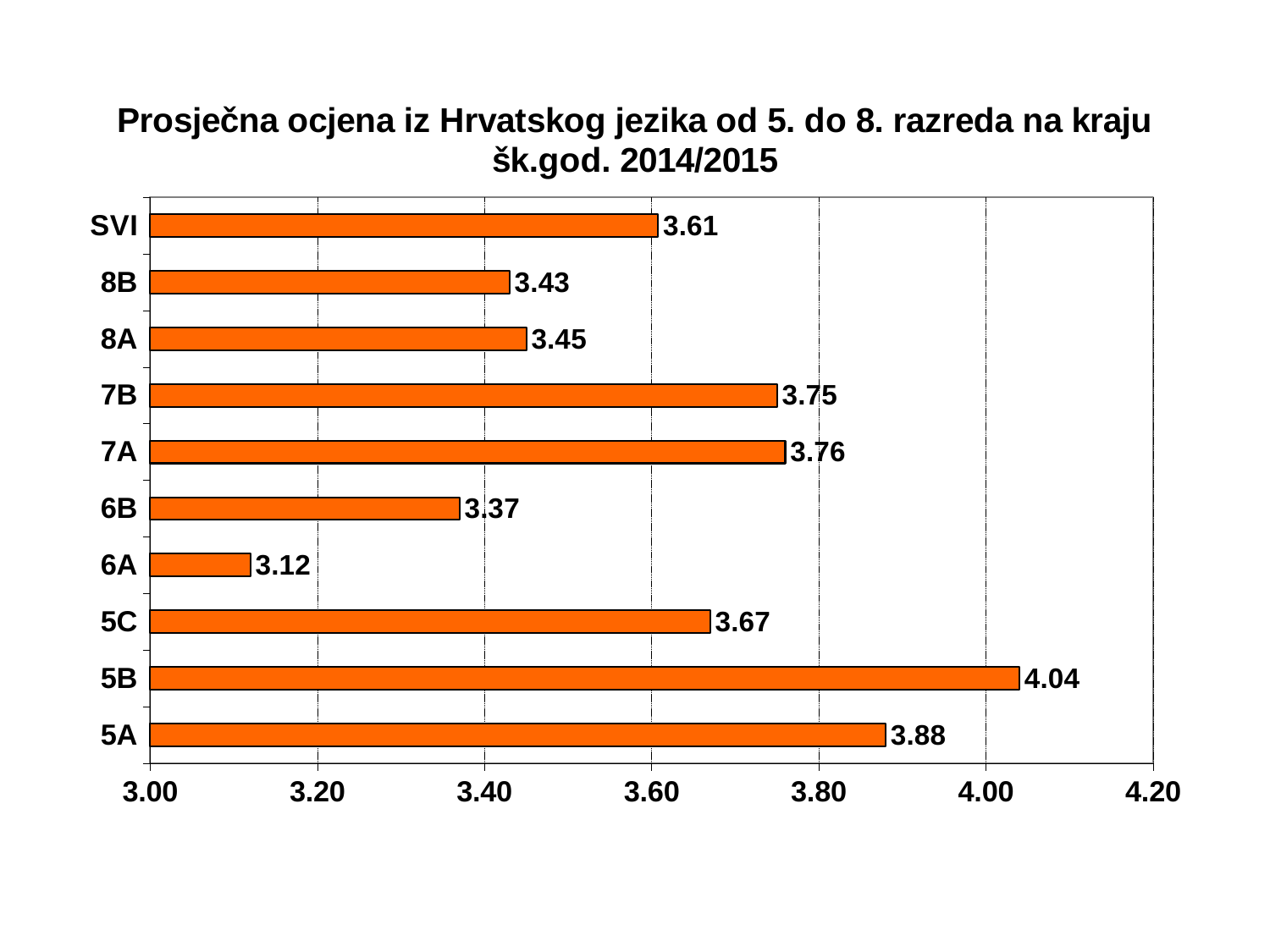
Is the value for 6B greater or less than 3.40? less What is the title of the chart? Prosječna ocjena iz Hrvatskog jezika od 5. do 8. razreda na kraju šk.god. 2014/2015 Which class has the highest average grade? 5B What is the average grade for class 6A? 3.12 What is the difference between the values for 5B and 5A? 0.16 Which class has the lowest average grade? 6A What is the average grade for class 5B? 4.04 What is the value shown for SVI? 3.61 What is the difference between the values for 7A and 6A? 0.64 Which has a higher average grade, 8A or 5C? 5C How many bars are shown in the chart? 10 What kind of chart is shown on the slide? bar chart